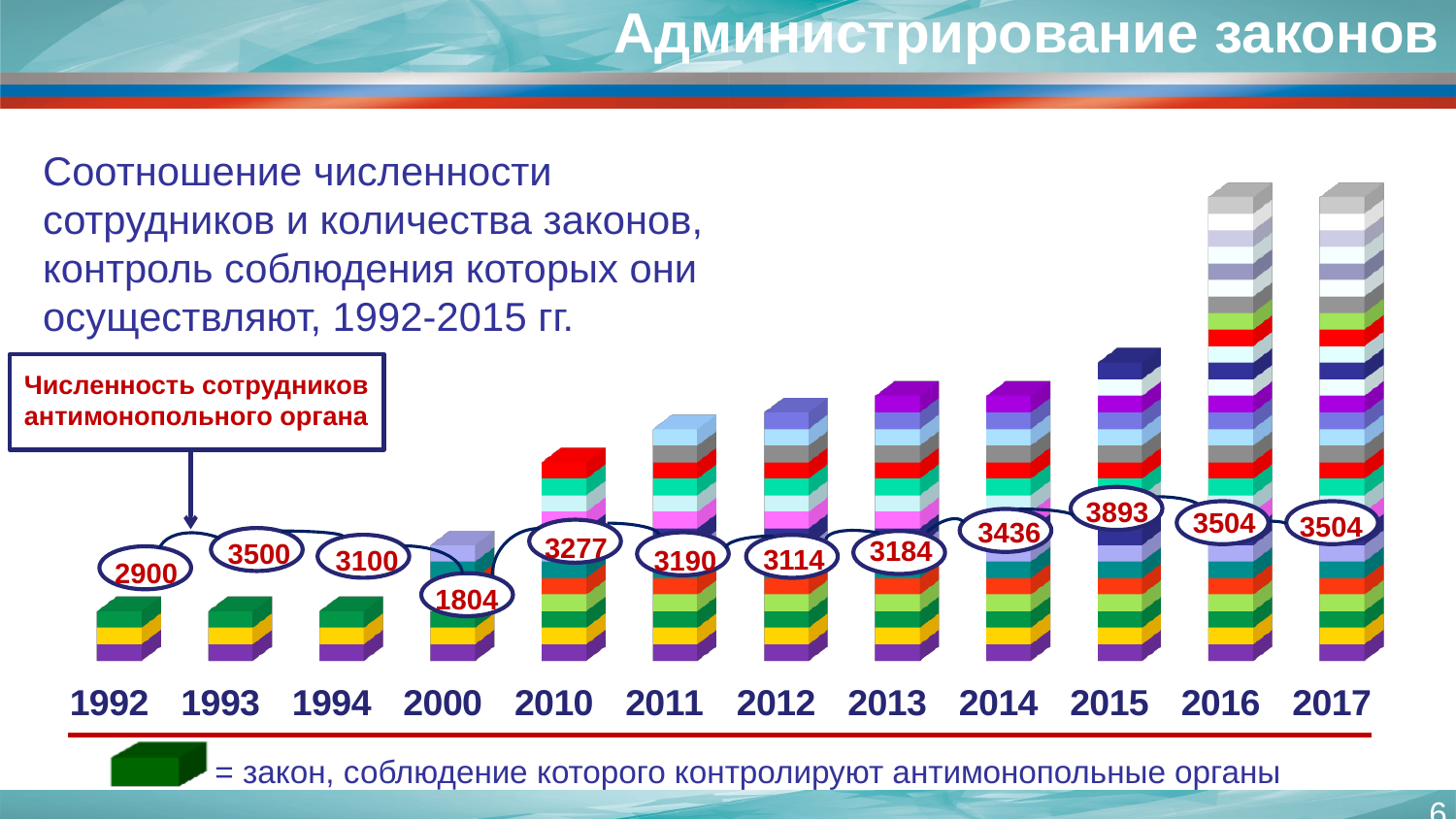
Do the bar heights (number of laws) generally rise or fall from 1992 to 2017? Rise What is the number of antimonopoly authority staff shown for 2000? 1804 What is the difference between the staff numbers for 2015 and 2016? 389 What is the difference between the staff numbers for 1993 and 1992? 600 What is the number of antimonopoly authority staff shown for 1992? 2900 Which year has the larger staff number, 1993 or 1994? 1993 What is the number of antimonopoly authority staff shown for 2015? 3893 How many years are shown on the x axis of the chart? 12 What is the number of antimonopoly authority staff shown for 2017? 3504 What kind of chart is shown on the slide? Stacked bar chart In which year is the labelled staff number the highest? 2015 In which year is the labelled staff number the lowest? 2000